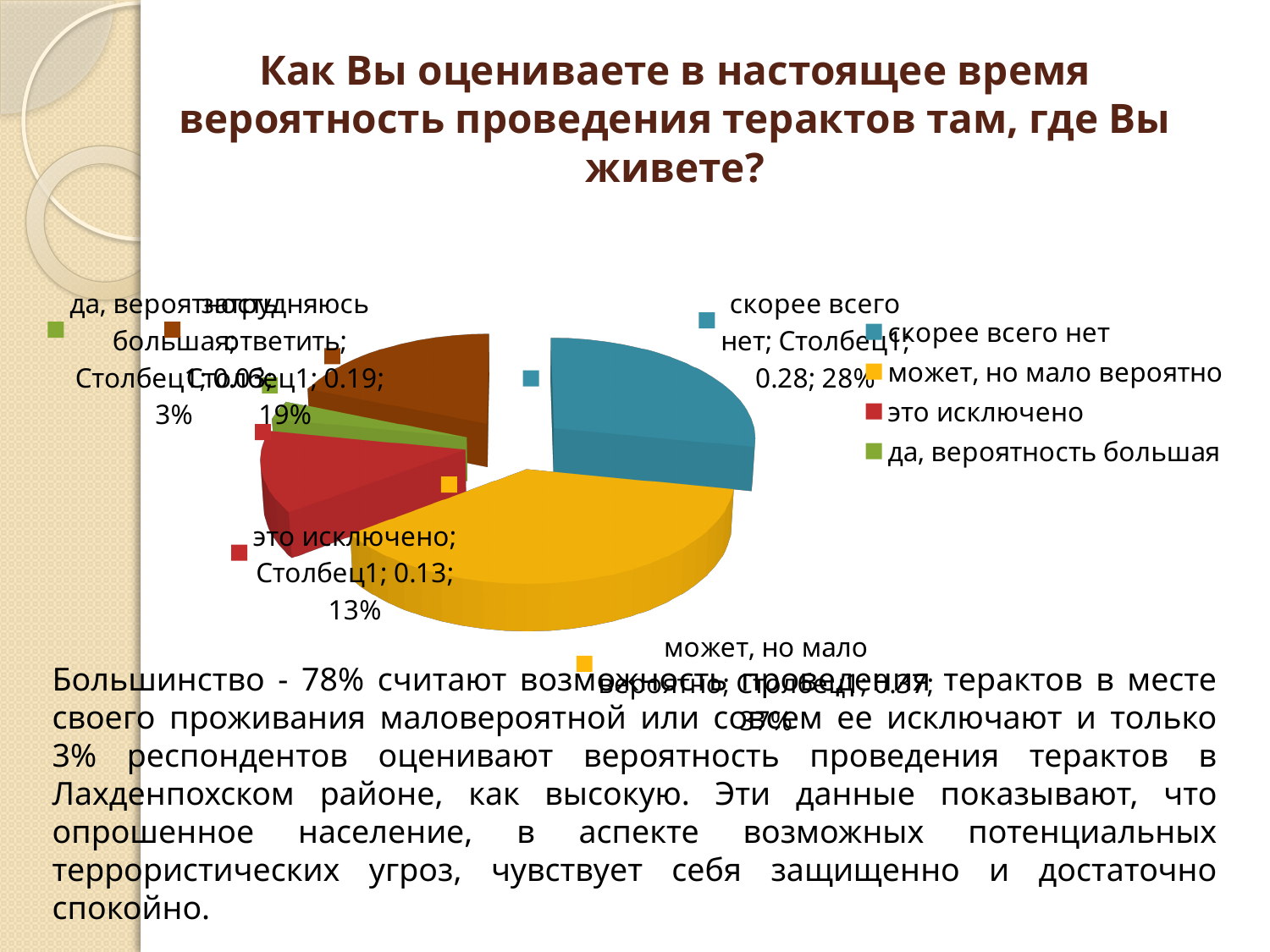
What percentage of respondents answered "может, но мало вероятно"? 37% What percentage of respondents answered "скорее всего нет"? 28% Which answer option has the smallest share of the pie? да, вероятность большая Which is larger: the share for "затрудняюсь ответить" or the share for "это исключено"? затрудняюсь ответить How many slices does the pie chart have? 5 Which answer option has the largest share of the pie? может, но мало вероятно What percentage of respondents answered "затрудняюсь ответить"? 19% What is the difference in percentage points between "может, но мало вероятно" and "скорее всего нет"? 9 What colour is the slice for "может, но мало вероятно"? yellow What kind of chart is shown on the slide? pie chart What percentage of respondents answered "да, вероятность большая"? 3% What percentage of respondents answered "это исключено"? 13%